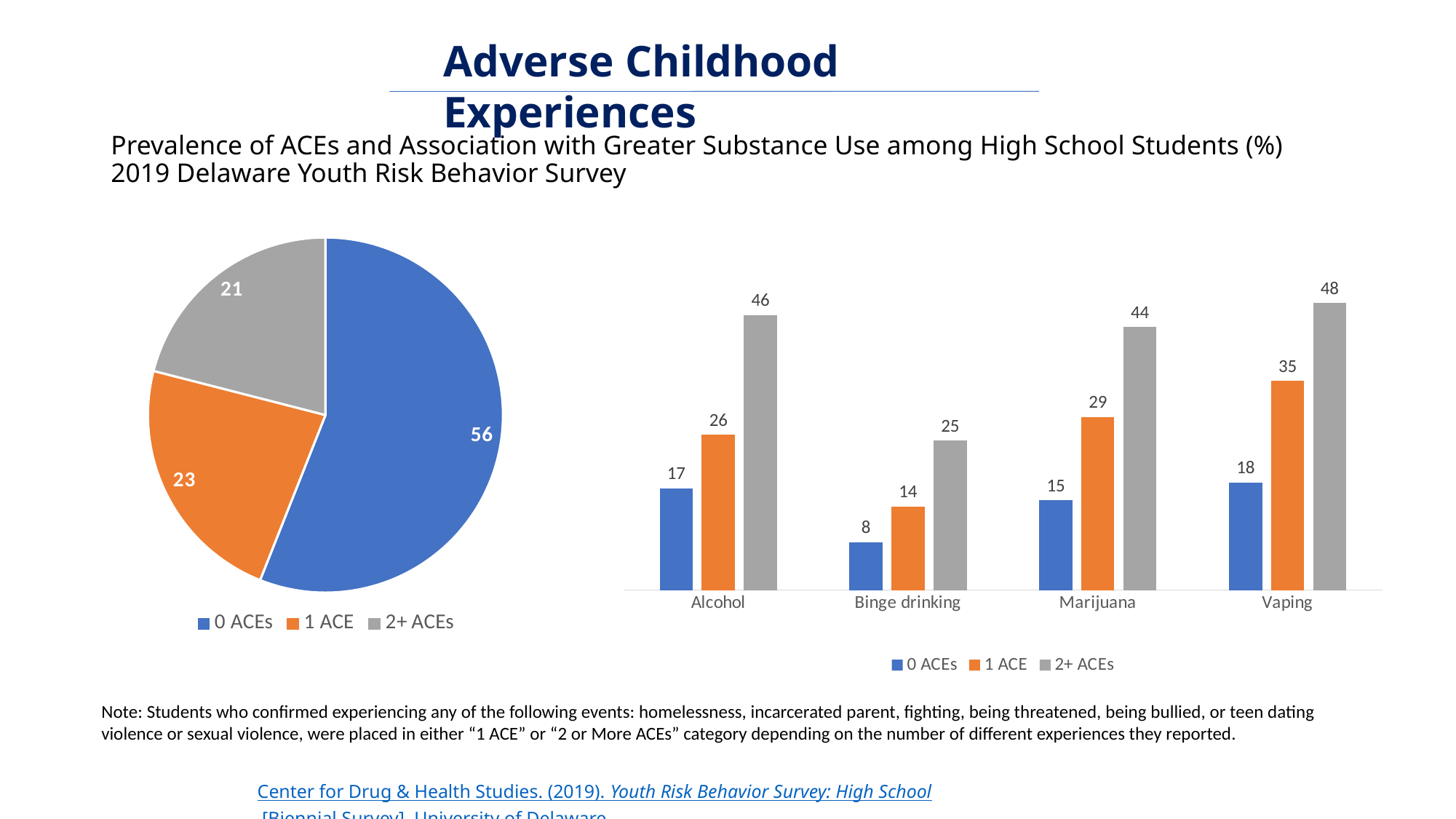
In the bar chart on the right, which category has the highest value for the 1 ACE series? Vaping In the pie chart on the left, which category has the smallest slice? 2+ ACEs In the bar chart on the right, how many categories are shown on the x axis? 4 In the bar chart on the right, how many series does the legend list? 3 In the bar chart on the right, which is larger for Marijuana: the 1 ACE value or the 0 ACEs value? 1 ACE In the pie chart on the left, what value is shown for the 0 ACEs slice? 56 What kind of chart is on the right side of the slide? Bar chart In the bar chart on the right, what is the value for 0 ACEs for Binge drinking? 8 In the bar chart on the right, what is the value for 2+ ACEs for Vaping? 48 In the bar chart on the right, which colour represents the 2+ ACEs series? Gray In the pie chart on the left, how many slices are there? 3 In the bar chart on the right, what is the difference between the 2+ ACEs and 0 ACEs values for Alcohol? 29